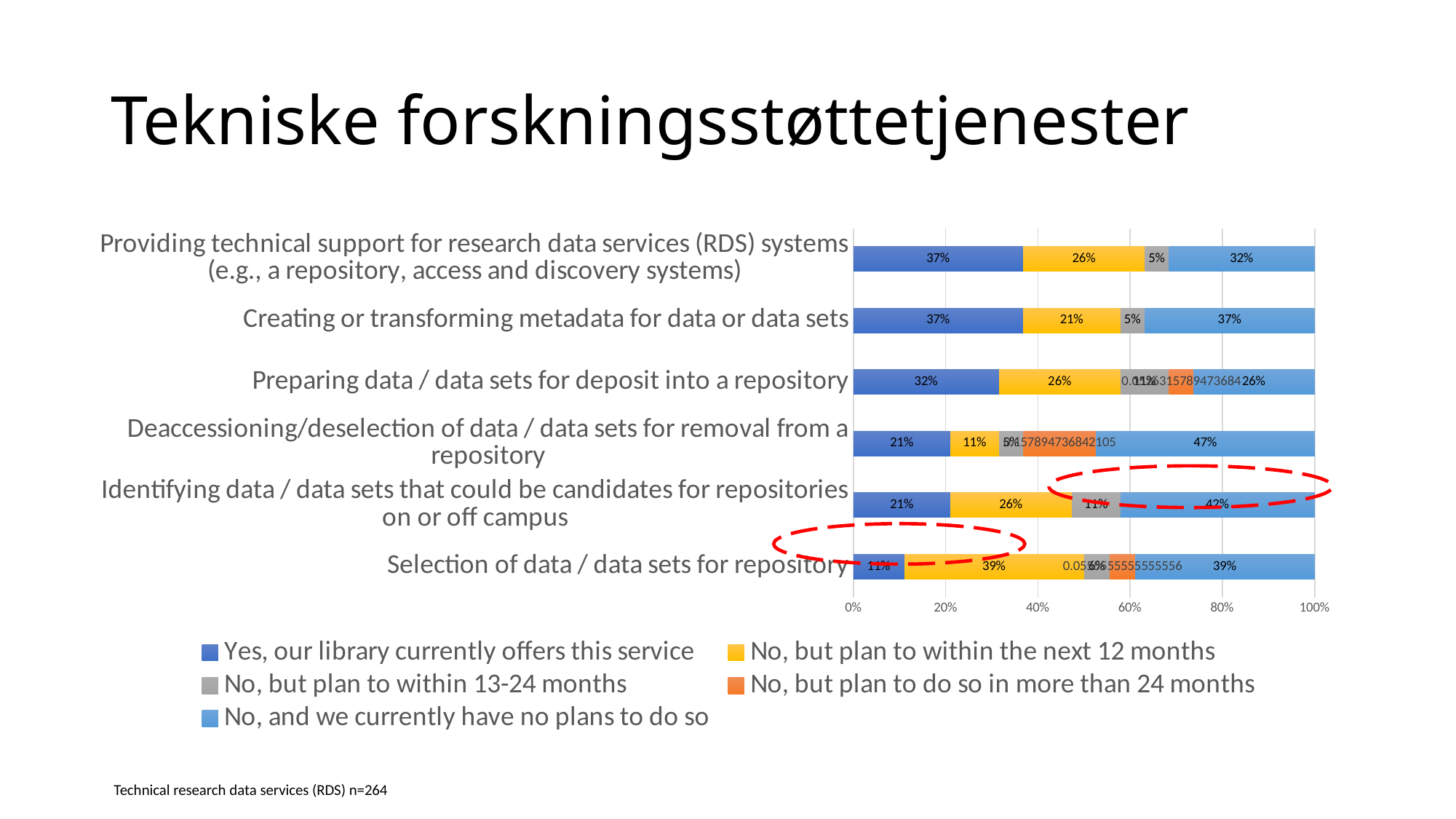
Which service has the highest 'No, and we currently have no plans to do so' share? Deaccessioning/deselection of data / data sets for removal from a repository What kind of chart is shown on the slide? Stacked bar chart What is the 'Yes, our library currently offers this service' value for 'Identifying data / data sets that could be candidates for repositories on or off campus'? 21% Which is larger: the 'Yes, our library currently offers this service' share for 'Creating or transforming metadata for data or data sets' or for 'Identifying data / data sets that could be candidates for repositories on or off campus'? Creating or transforming metadata for data or data sets For 'Providing technical support for research data services (RDS) systems', what is the difference between the 'Yes, our library currently offers this service' share and the 'No, but plan to within the next 12 months' share? 11 percentage points How many series does the chart legend list? 5 How many service categories are listed on the chart? 6 Which colour represents 'No, but plan to do so in more than 24 months' in the legend? Orange What is the 'No, but plan to within the next 12 months' value for 'Selection of data / data sets for repository'? 39% What percentage of libraries currently offer 'Creating or transforming metadata for data or data sets'? 37% Which service has the lowest 'Yes, our library currently offers this service' share? Selection of data / data sets for repository What is the 'No, and we currently have no plans to do so' value for 'Deaccessioning/deselection of data / data sets for removal from a repository'? 47%